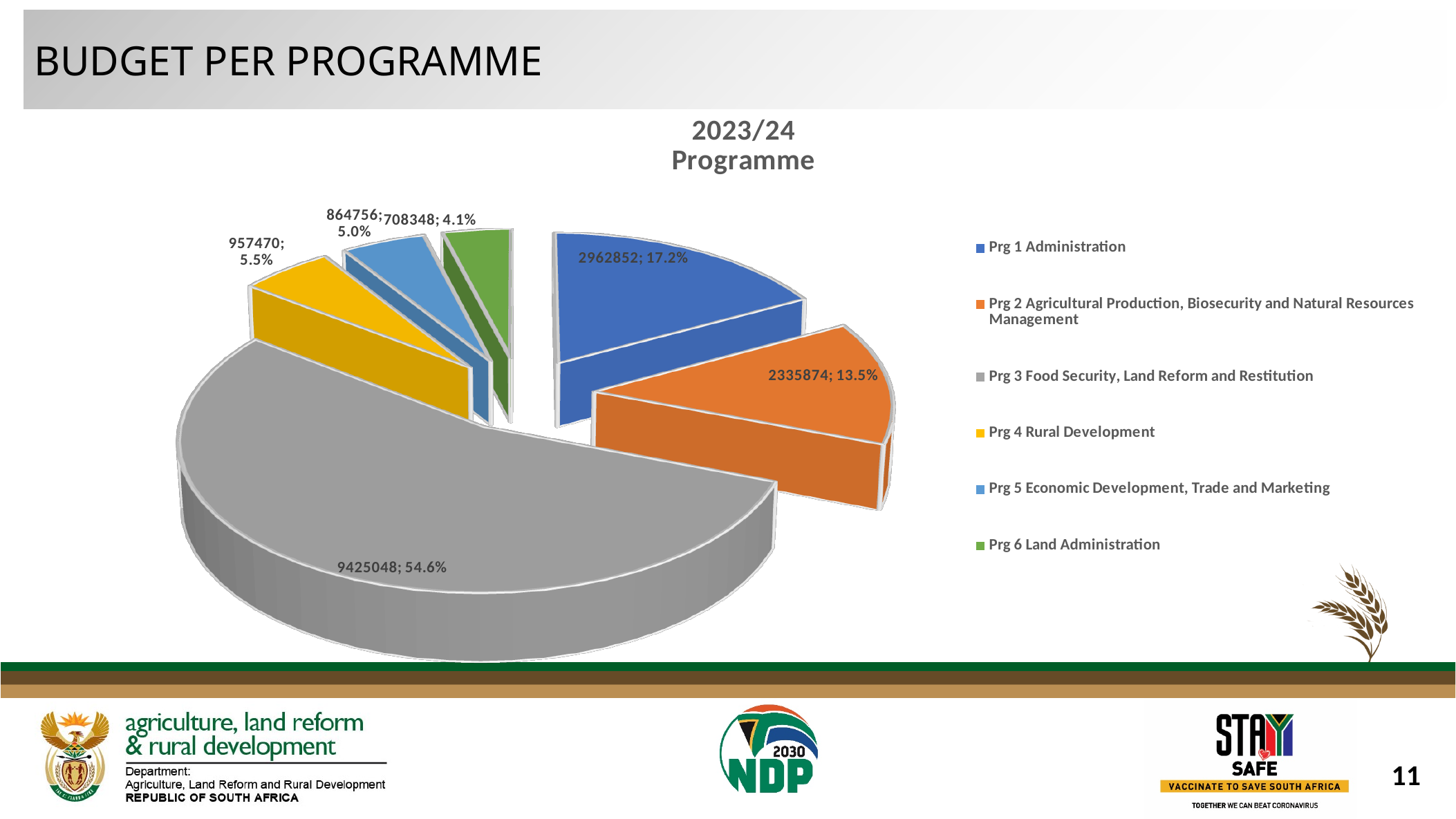
What is the budget value for Prg 3 Food Security, Land Reform and Restitution? 9425048 How many programmes are shown in the pie chart? 6 Which has a larger budget, Prg 4 Rural Development or Prg 5 Economic Development, Trade and Marketing? Prg 4 Rural Development Which programme has the largest budget? Prg 3 Food Security, Land Reform and Restitution Which programme has the smallest budget? Prg 6 Land Administration What is the budget value for Prg 1 Administration? 2962852 What is the difference between the budget for Prg 1 Administration and Prg 2 Agricultural Production, Biosecurity and Natural Resources Management? 626978 What colour is the slice for Prg 5 Economic Development, Trade and Marketing? Light blue What share of the pie does Prg 2 Agricultural Production, Biosecurity and Natural Resources Management represent? 13.5% What share of the pie does Prg 4 Rural Development represent? 5.5% What is the budget value for Prg 6 Land Administration? 708348 What kind of chart is shown on the slide? Pie chart